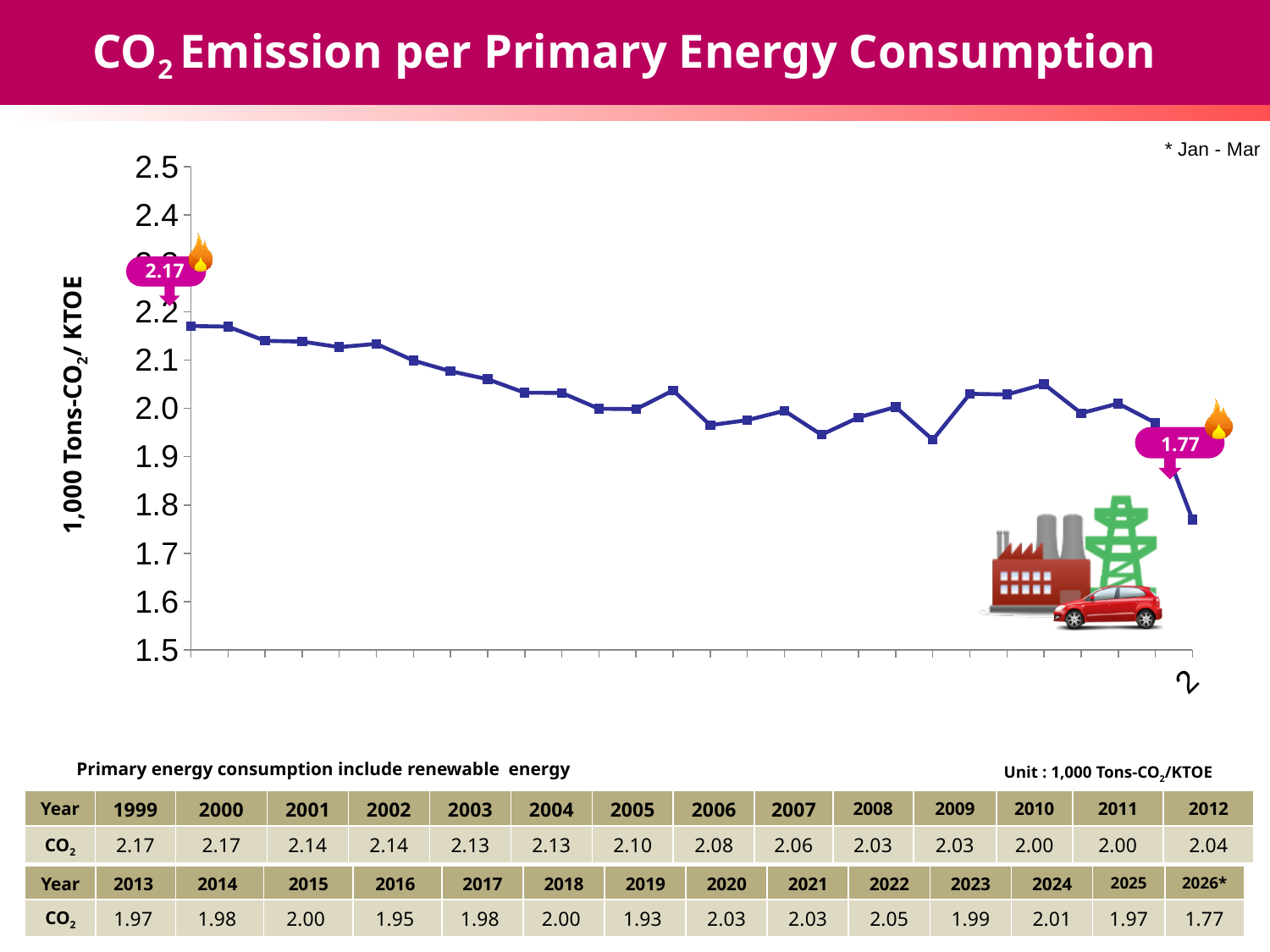
What kind of chart is shown on the slide? line chart Overall, do the values rise or fall from 1999 to 2026*? fall What is the CO2 emission per primary energy consumption value labelled at the start of the line (1999)? 2.17 Which year has the lowest CO2 emission per primary energy consumption? 2026* Is the value for 2019 greater or less than 2.0? less Which is larger, the CO2 value for 2012 or for 2013? 2012 What is the difference between the 1999 value (2.17) and the 2026* value (1.77)? 0.40 What is the CO2 value for 2012 according to the table? 2.04 What is the CO2 value for 2019 according to the table? 1.93 What is the CO2 emission per primary energy consumption value labelled at the end of the line (2026*)? 1.77 What is the highest CO2 value shown in the table? 2.17 How many years (data points) are plotted on the chart? 28